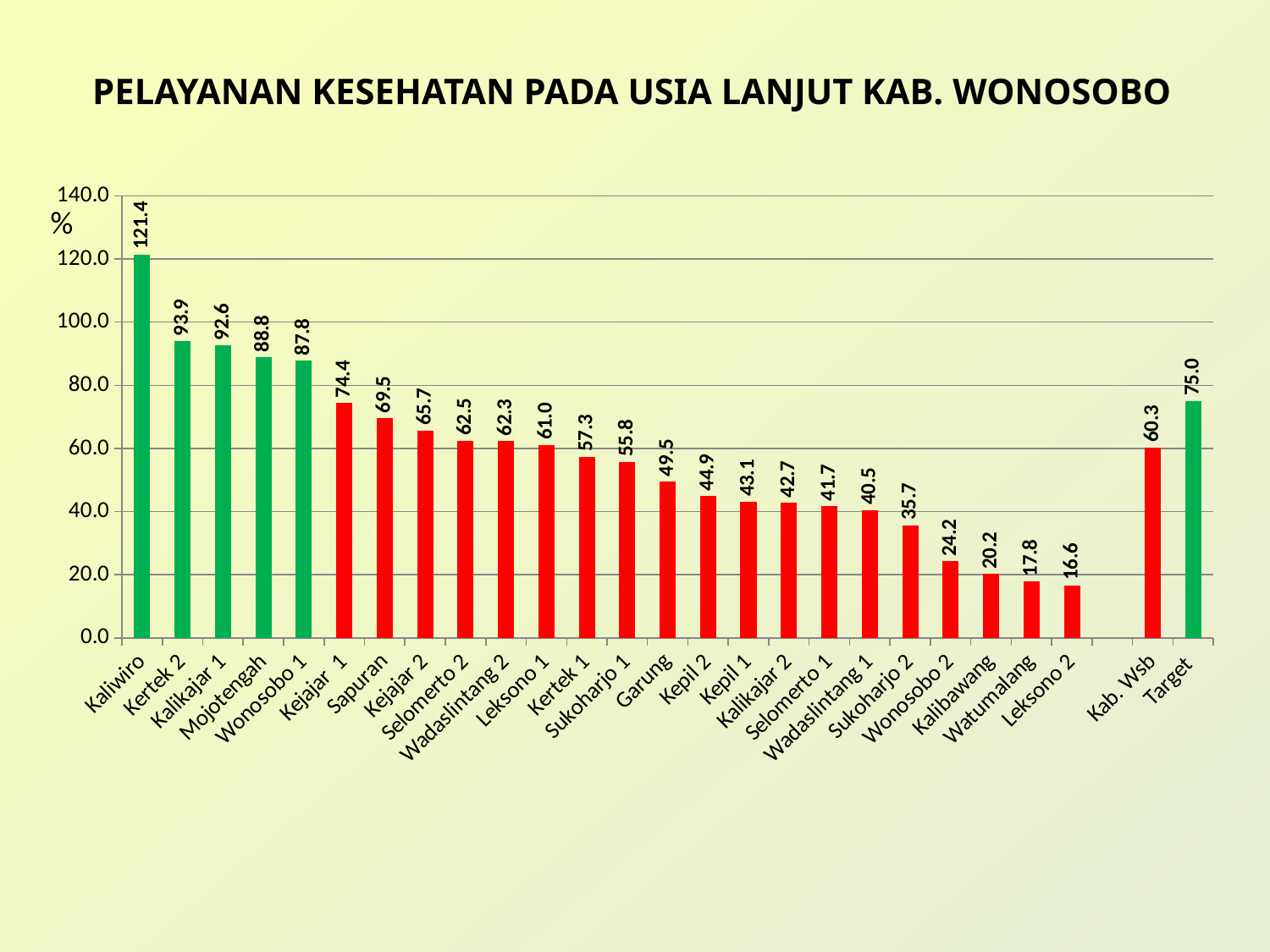
What kind of chart is shown on the slide? Bar chart What is the title of the chart? PELAYANAN KESEHATAN PADA USIA LANJUT KAB. WONOSOBO Which is larger, the value for Sapuran or the value for Garung? Sapuran What is the difference between the values for Kertek 2 and Kertek 1? 36.6 What is the value shown for Target? 75.0 Which category has the lowest value? Leksono 2 How many bars are plotted in the chart? 26 What is the value for Kaliwiro? 121.4 Is the value for Mojotengah greater or less than 80.0? greater Which category has the highest value? Kaliwiro What is the value for Sukoharjo 2? 35.7 What is the value for Kab. Wsb? 60.3